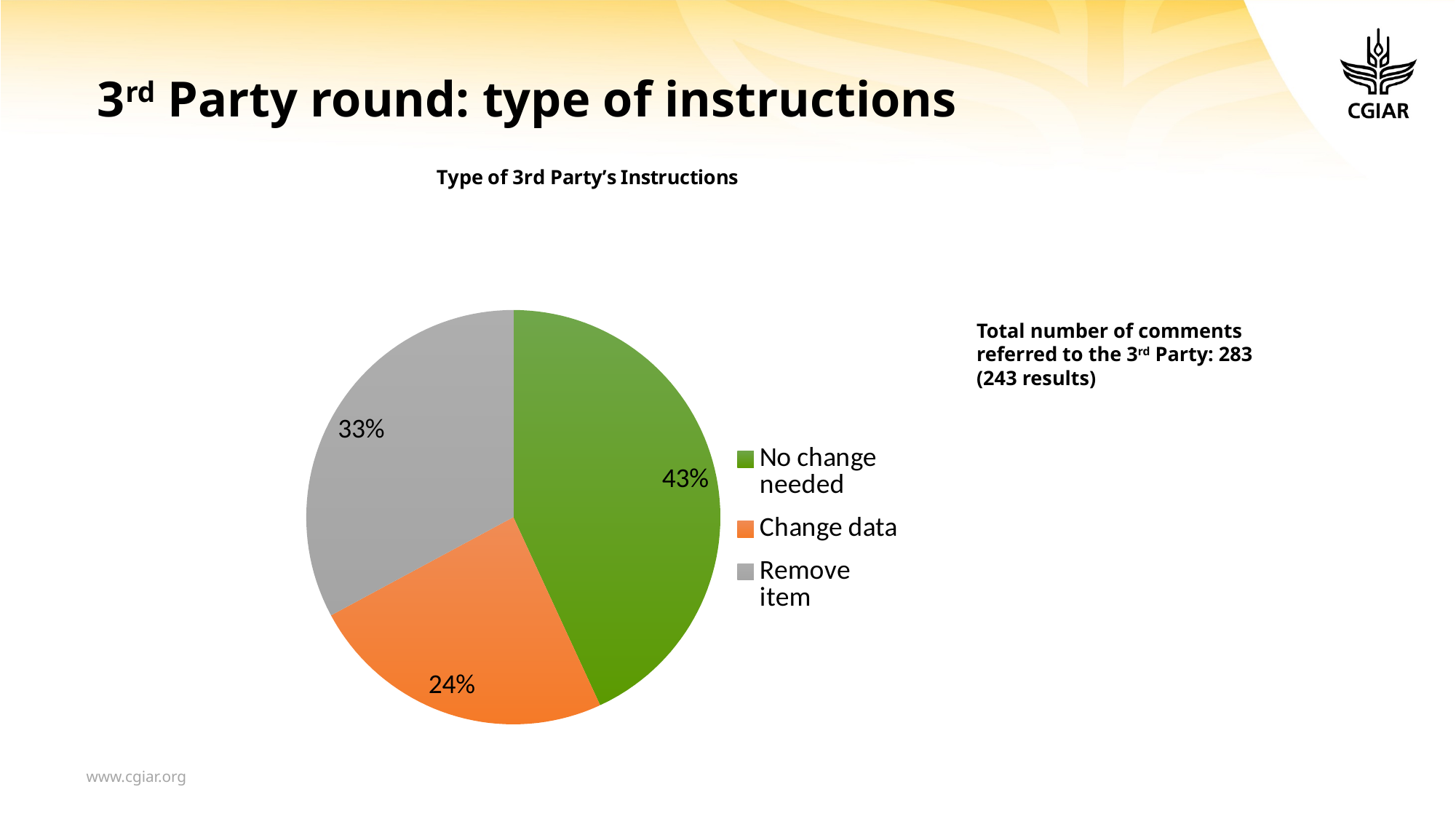
Which category has the largest slice of the pie? No change needed What is the difference in percentage points between "No change needed" and "Change data"? 19 How many categories does the pie chart show? 3 What is the difference in percentage points between "Remove item" and "Change data"? 9 What is the title of the chart? Type of 3rd Party's Instructions Which category has the smallest slice of the pie? Change data What share of the pie does "No change needed" represent? 43% What share of the pie does "Change data" represent? 24% Which is larger, the share for "Remove item" or the share for "Change data"? Remove item Which colour represents "Change data" in the pie chart? Orange What kind of chart is shown on the slide? Pie chart What share of the pie does "Remove item" represent? 33%